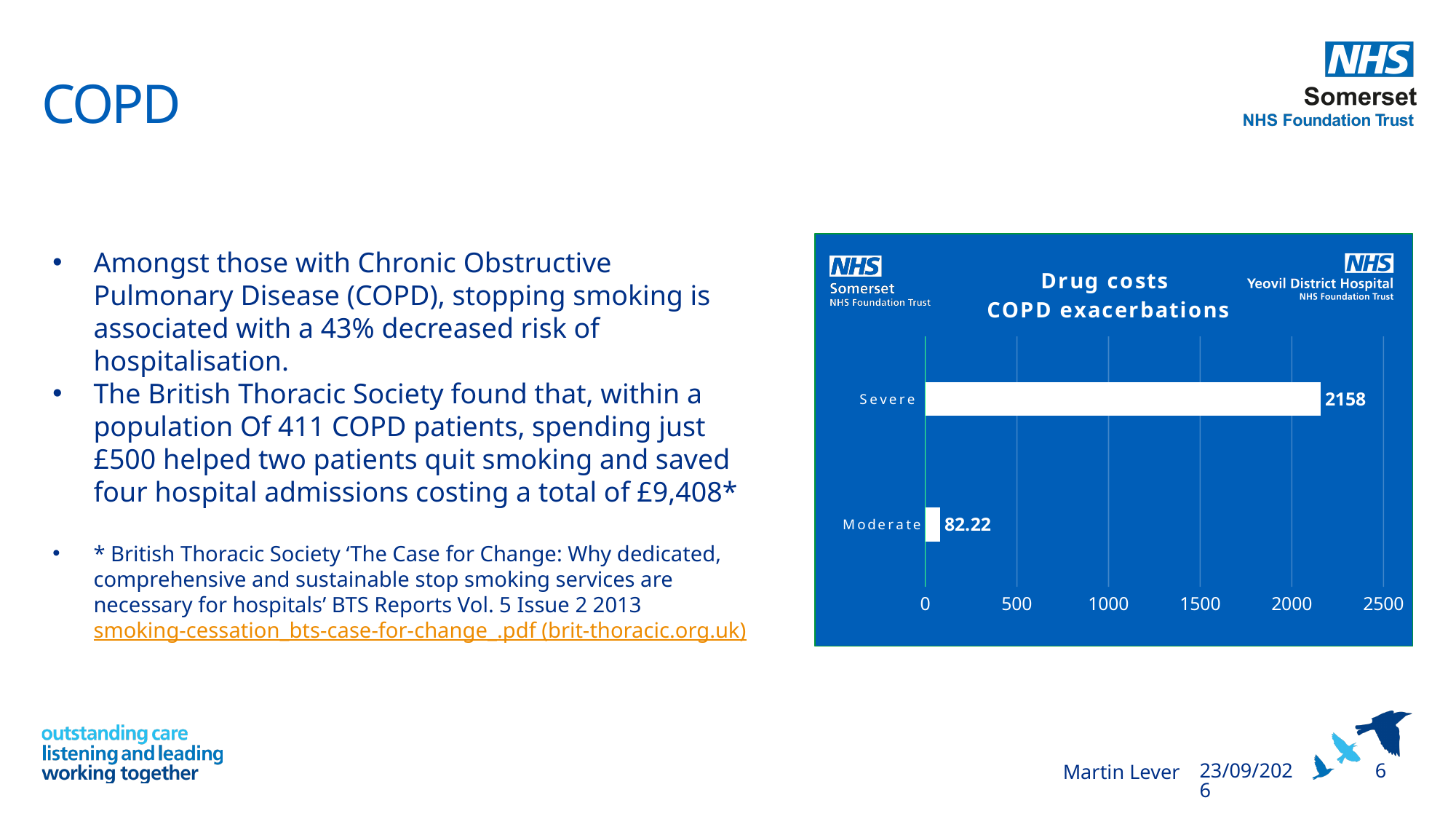
What is the drug cost value for Moderate COPD exacerbations? 82.22 What is the maximum value shown on the chart's value axis? 2500 Which category has the highest drug cost? Severe Is the drug cost for Moderate exacerbations greater or less than 500? less What type of chart is shown on the slide? Bar chart How many categories are shown in the chart? 2 Which has a larger drug cost, Severe or Moderate exacerbations? Severe Is the drug cost for Severe exacerbations greater or less than 2000? greater What is the drug cost value for Severe COPD exacerbations? 2158 What is the difference in drug costs between Severe and Moderate exacerbations? 2075.78 Which category has the lowest drug cost? Moderate What is the title of the chart? Drug costs COPD exacerbations